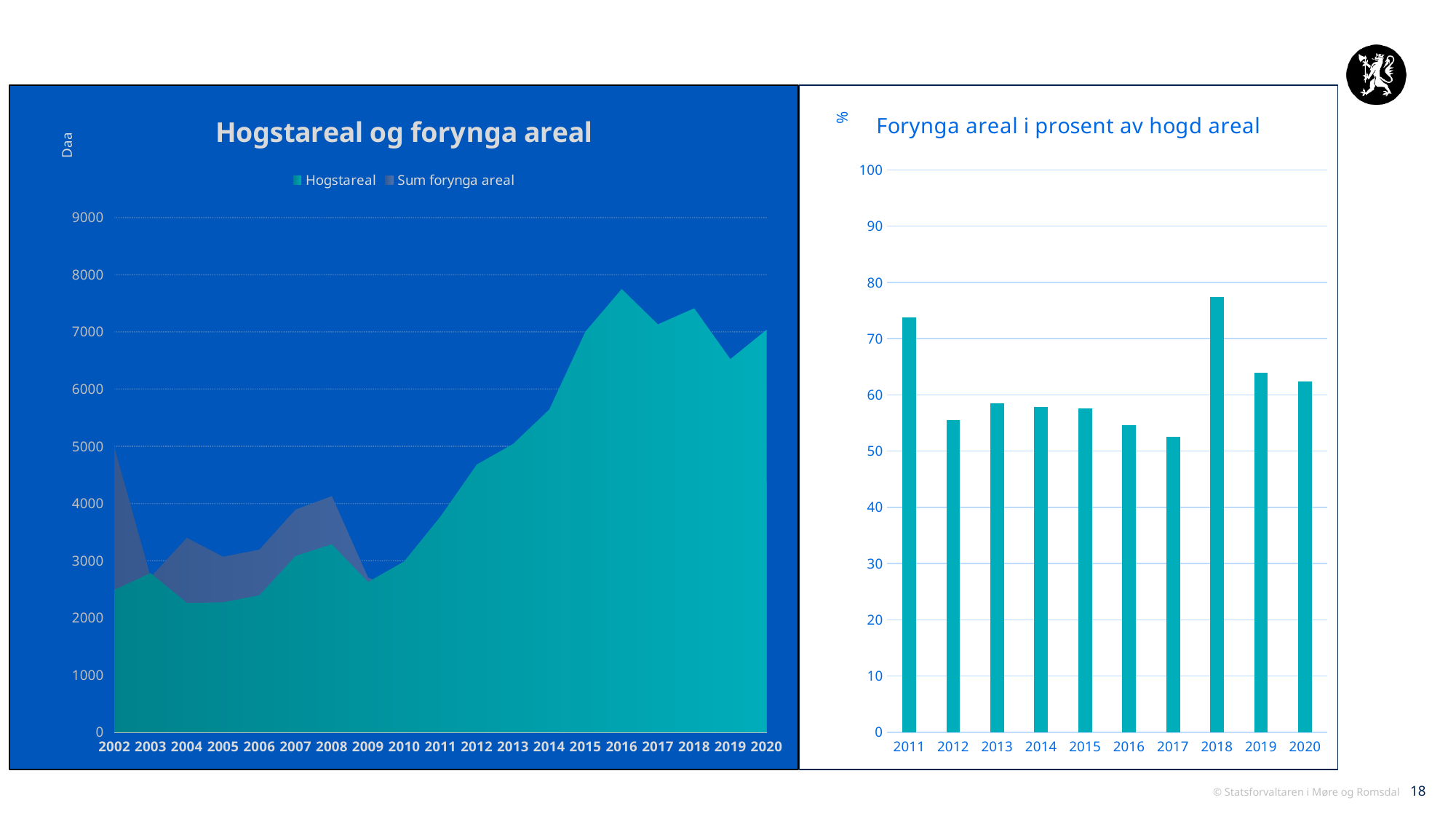
In the chart 'Hogstareal og forynga areal', in which year does Hogstareal reach its highest value? 2016 In the chart 'Forynga areal i prosent av hogd areal', is the value for 2012 greater or less than 60? less What kind of chart is the right-hand chart, 'Forynga areal i prosent av hogd areal'? bar chart In the chart 'Forynga areal i prosent av hogd areal', which year has the highest value? 2018 What kind of chart is the left-hand chart, 'Hogstareal og forynga areal'? area chart In the chart 'Forynga areal i prosent av hogd areal', which is larger, the value for 2019 or the value for 2016? 2019 In the chart 'Forynga areal i prosent av hogd areal', is the value for 2011 greater or less than 70? greater In the chart 'Forynga areal i prosent av hogd areal', how many years are shown on the x axis? 10 In the chart 'Hogstareal og forynga areal', does Hogstareal rise or fall from 2009 to 2016? rise How many series does the legend of the chart 'Hogstareal og forynga areal' list? 2 In the chart 'Hogstareal og forynga areal', is the Hogstareal value for 2016 greater or less than 7000? greater In the chart 'Forynga areal i prosent av hogd areal', which year has the lowest value? 2017